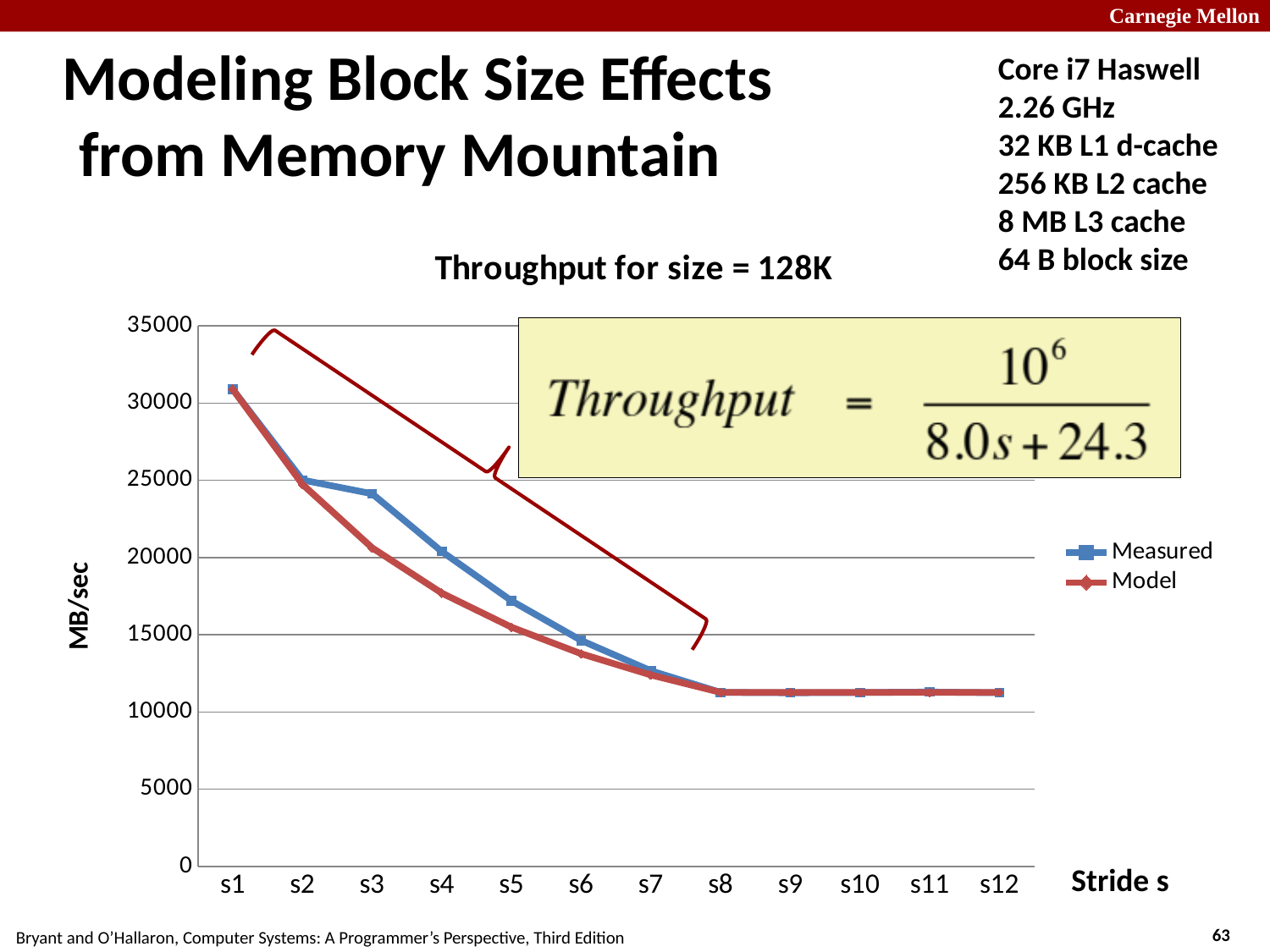
Is the Measured value at s3 greater or less than 20000? greater What are the two series named in the legend? Measured and Model Do the Measured values rise or fall as the stride increases from s1 to s12? fall At stride s3, which series has the larger value, Measured or Model? Measured What kind of chart is shown on the slide? line chart Is the Model value at s4 greater or less than 20000? less How many series does the legend list? 2 What is the title of the chart? Throughput for size = 128K Is the Measured value at s8 greater or less than 15000? less Which stride has the highest Measured throughput? s1 How many stride values are plotted along the x axis? 12